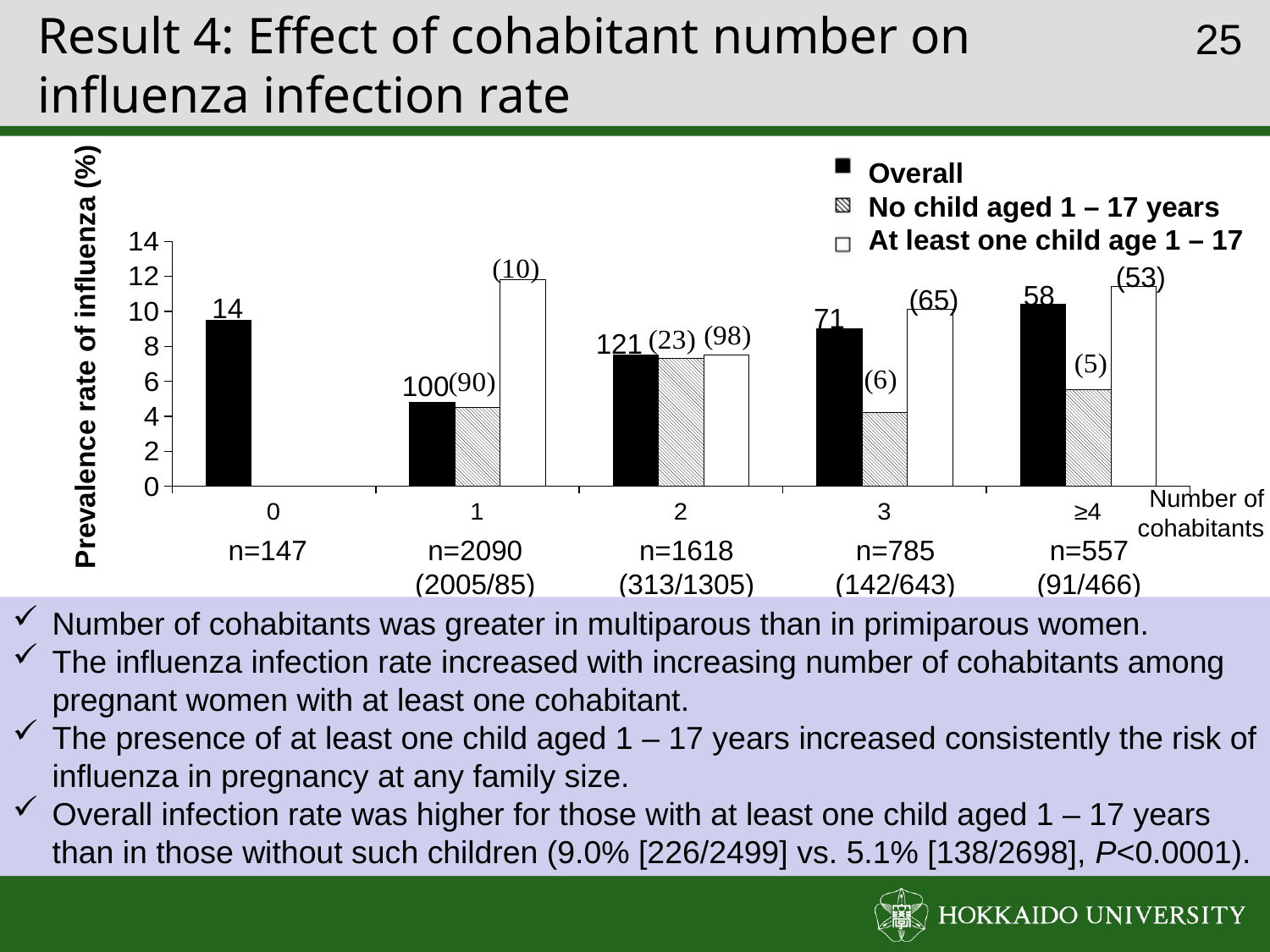
Is the Overall prevalence rate for 0 cohabitants greater or less than 8? greater Is the prevalence rate for 'At least one child age 1 – 17' at 1 cohabitant greater or less than 10? greater Is the prevalence rate for 'No child aged 1 – 17 years' at 3 cohabitants greater or less than 6? less How many cohabitant-number categories are shown on the x axis? 5 What is the title of the y axis? Prevalence rate of influenza (%) What number is printed above the Overall bar for 0 cohabitants? 14 What kind of chart is shown on the slide? bar chart At 3 cohabitants, which series has the larger prevalence rate: 'No child aged 1 – 17 years' or 'At least one child age 1 – 17'? At least one child age 1 – 17 How many series does the legend list? 3 Which cohabitant-number category has the lowest Overall prevalence rate? 1 Which cohabitant-number category has the highest prevalence rate for the 'No child aged 1 – 17 years' series? 2 Which cohabitant-number category has the lowest prevalence rate for the 'At least one child age 1 – 17' series? 2